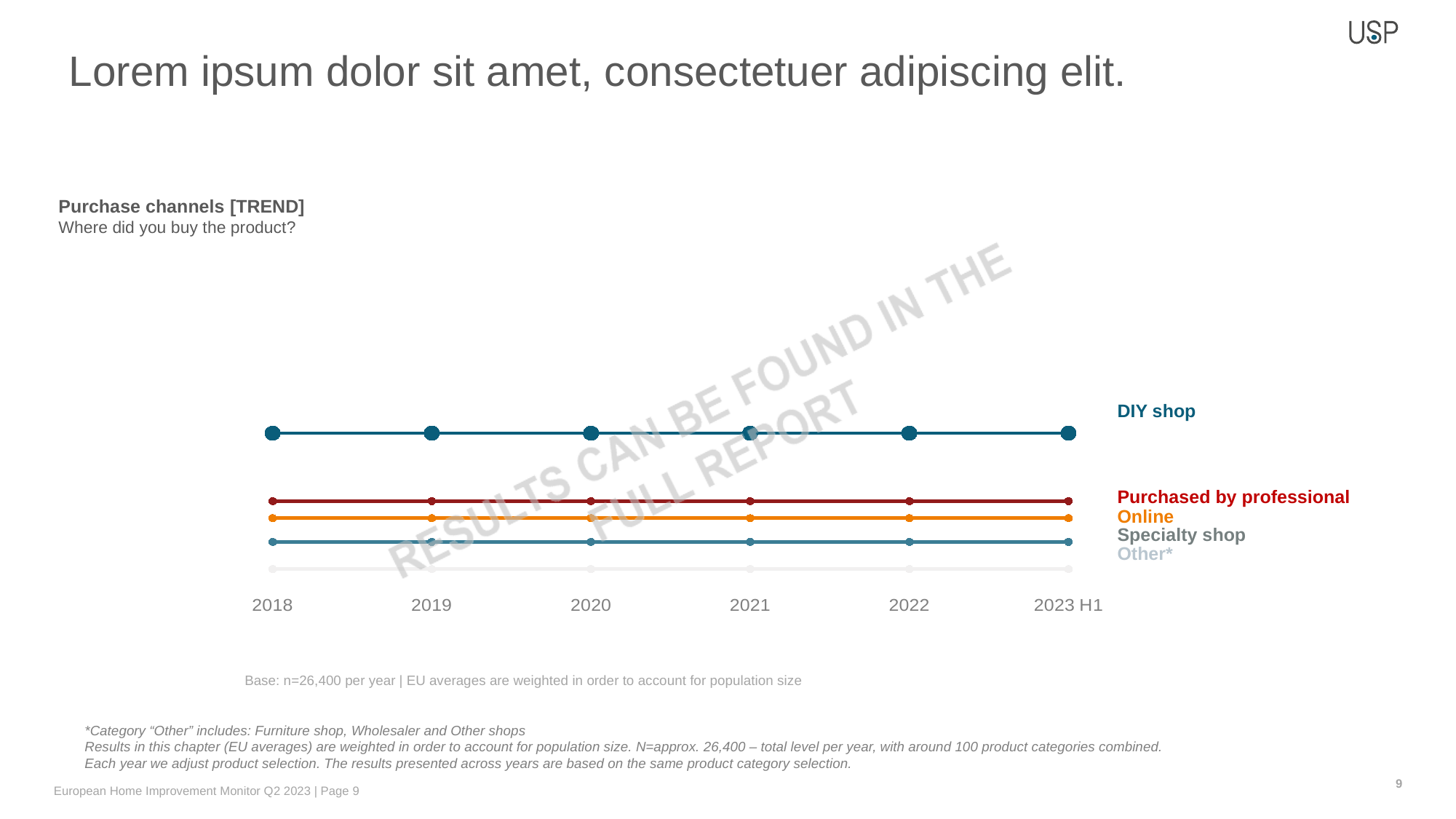
What is the first year shown on the x axis of the chart? 2018 In 2023 H1, which is larger: DIY shop or Online? DIY shop What kind of chart is shown on the slide? Line chart Which purchase channel has the lowest values across all years in the chart? Other* How many time points are shown on the x axis of the chart? 6 How many series are plotted in the chart? 5 What is the title of the chart? Purchase channels [TREND] Do the values for DIY shop rise, fall or stay flat from 2018 to 2023 H1? Stay flat Which purchase channel has the highest values across all years in the chart? DIY shop In 2018, which is larger: Specialty shop or Other*? Specialty shop In 2020, which is larger: Purchased by professional or Specialty shop? Purchased by professional